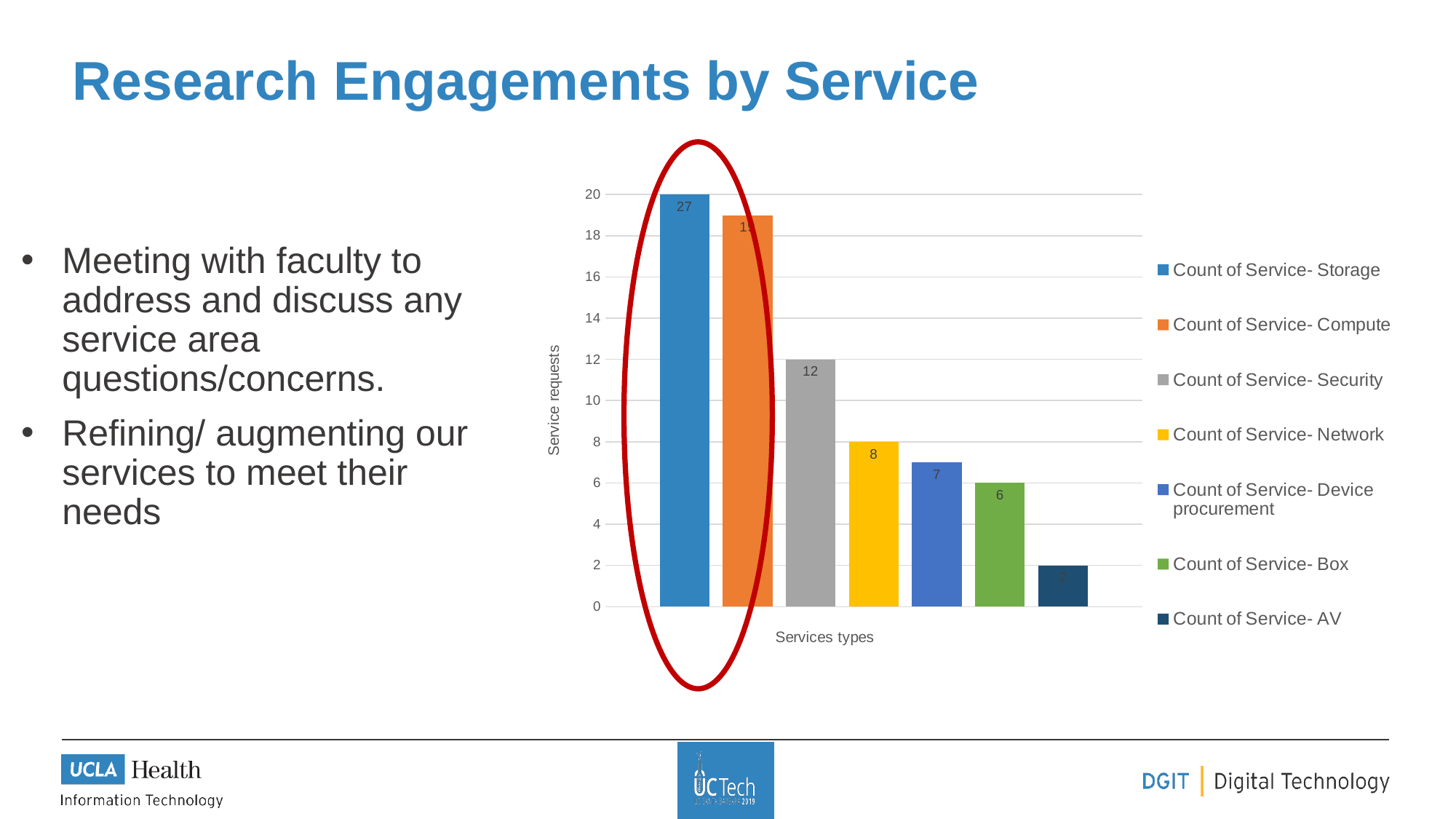
Which service has the highest count? Count of Service- Storage How many entries does the legend list? 7 Which service has the lowest count? Count of Service- AV What is the value for Count of Service- Box? 6 What is the value for Count of Service- Network? 8 Which is larger, the value for Box or the value for Device procurement? Device procurement What is the value for Count of Service- AV? 2 What kind of chart is shown on the slide? bar chart Is the value for Count of Service- Compute greater or less than 10? greater What is the difference between the values for Security and Network? 4 What is the value for Count of Service- Device procurement? 7 What is the value for Count of Service- Security? 12